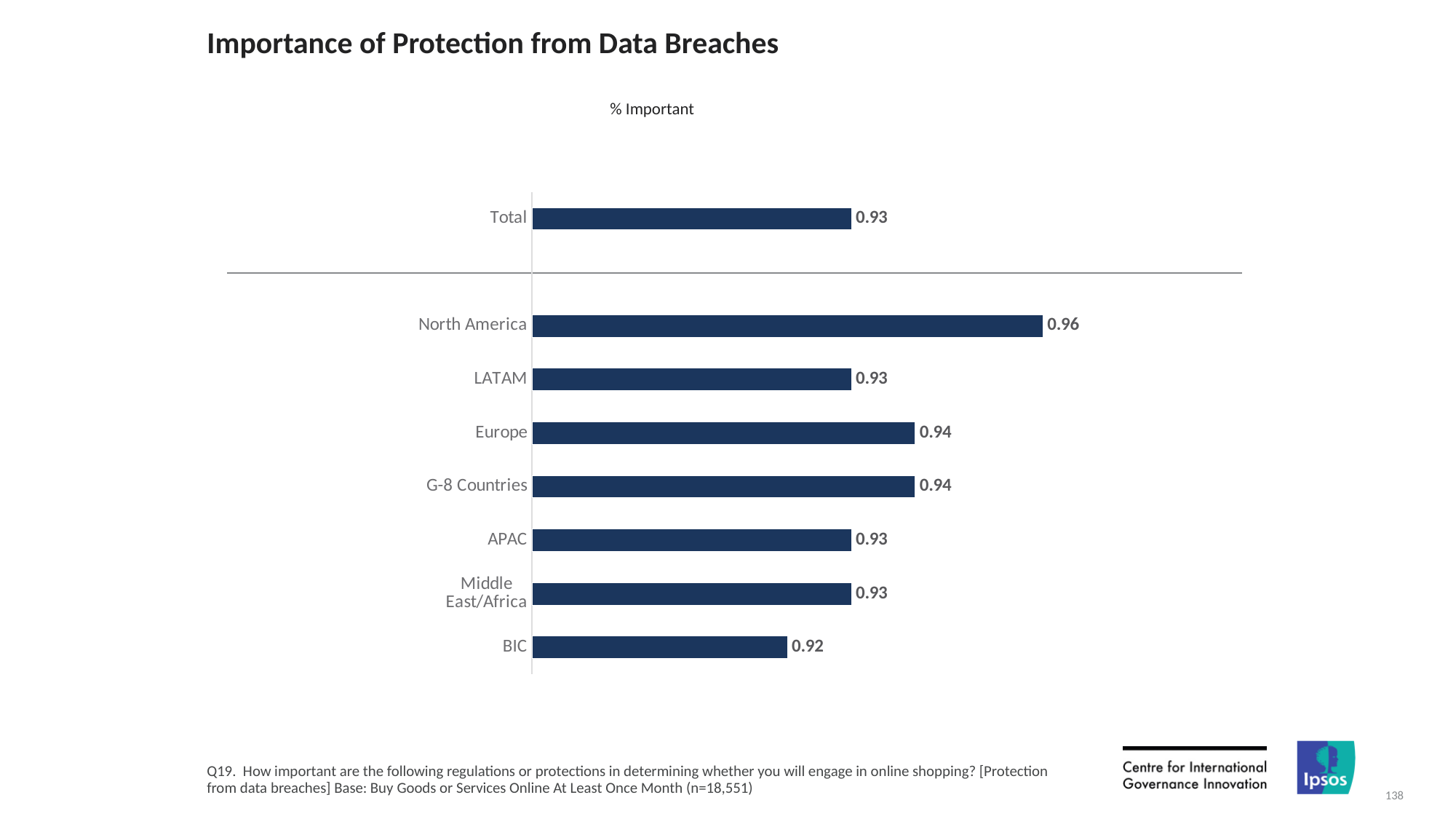
What is the value for Middle East/Africa? 0.93 Which is larger, the value for North America or the value for LATAM? North America What is the value for North America? 0.96 What is the difference between the values for North America and BIC? 0.04 Which category has the highest value? North America Which category has the lowest value? BIC What kind of chart is shown on the slide? Bar chart What is the value for Total? 0.93 How many categories are plotted in the chart? 8 What is the value for Europe? 0.94 What is the title of the chart? % Important What is the value for BIC? 0.92